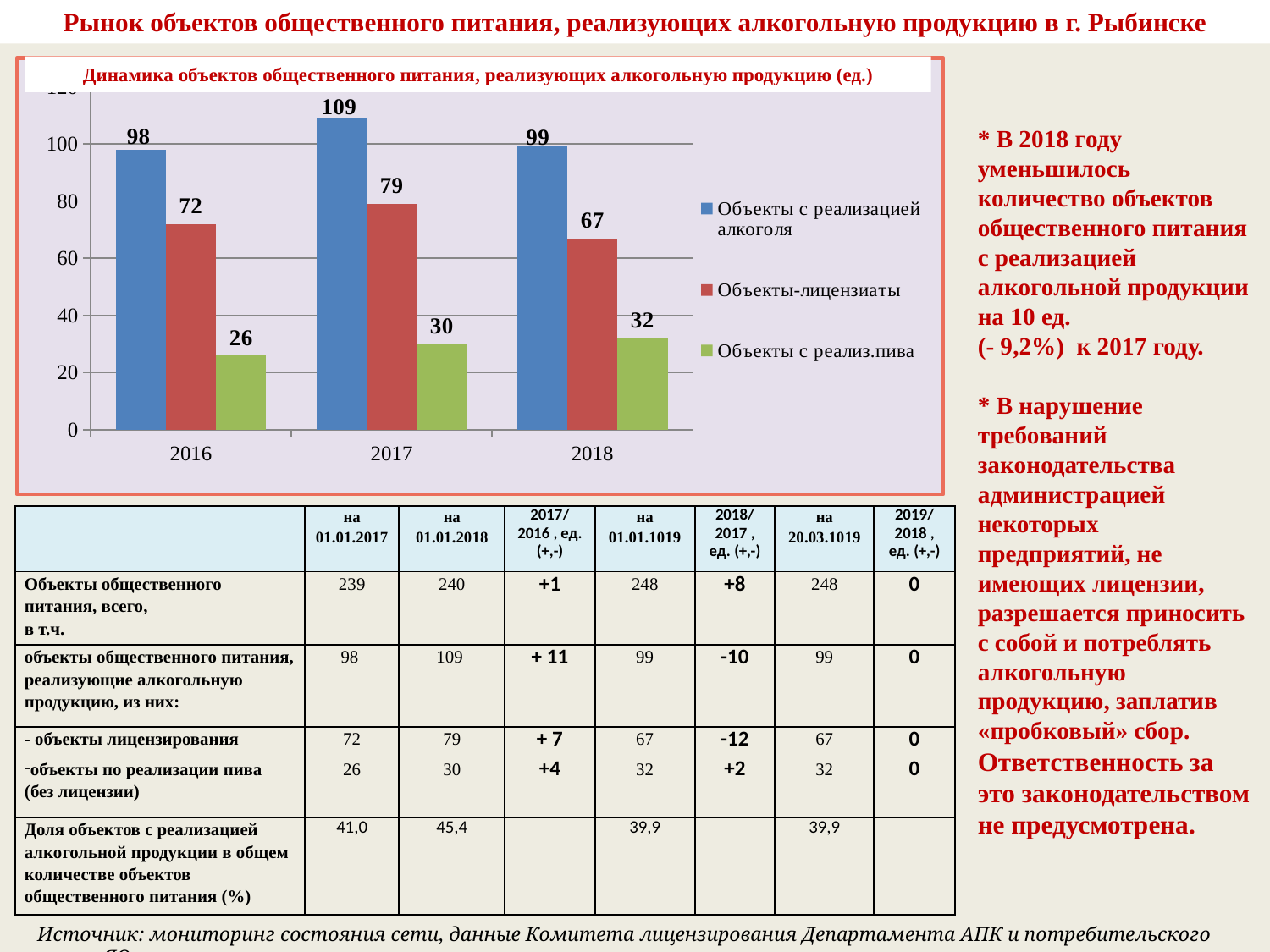
Which is larger: "Объекты с реализ.пива" in 2018 or in 2016? 2018 What is the value for "Объекты с реализацией алкоголя" in 2017? 109 In which year is the value for "Объекты с реализацией алкоголя" highest? 2017 What kind of chart is shown on the slide? bar chart What is the difference between the "Объекты-лицензиаты" values for 2017 and 2016? 7 What is the value for "Объекты-лицензиаты" in 2018? 67 Does the value for "Объекты с реализ.пива" rise or fall from 2016 to 2018? rise How many years are shown on the x axis of the chart? 3 What is the difference between the "Объекты с реализацией алкоголя" values for 2017 and 2018? 10 How many series does the chart legend list? 3 In which year is the value for "Объекты-лицензиаты" lowest? 2018 What is the value for "Объекты с реализ.пива" in 2016? 26